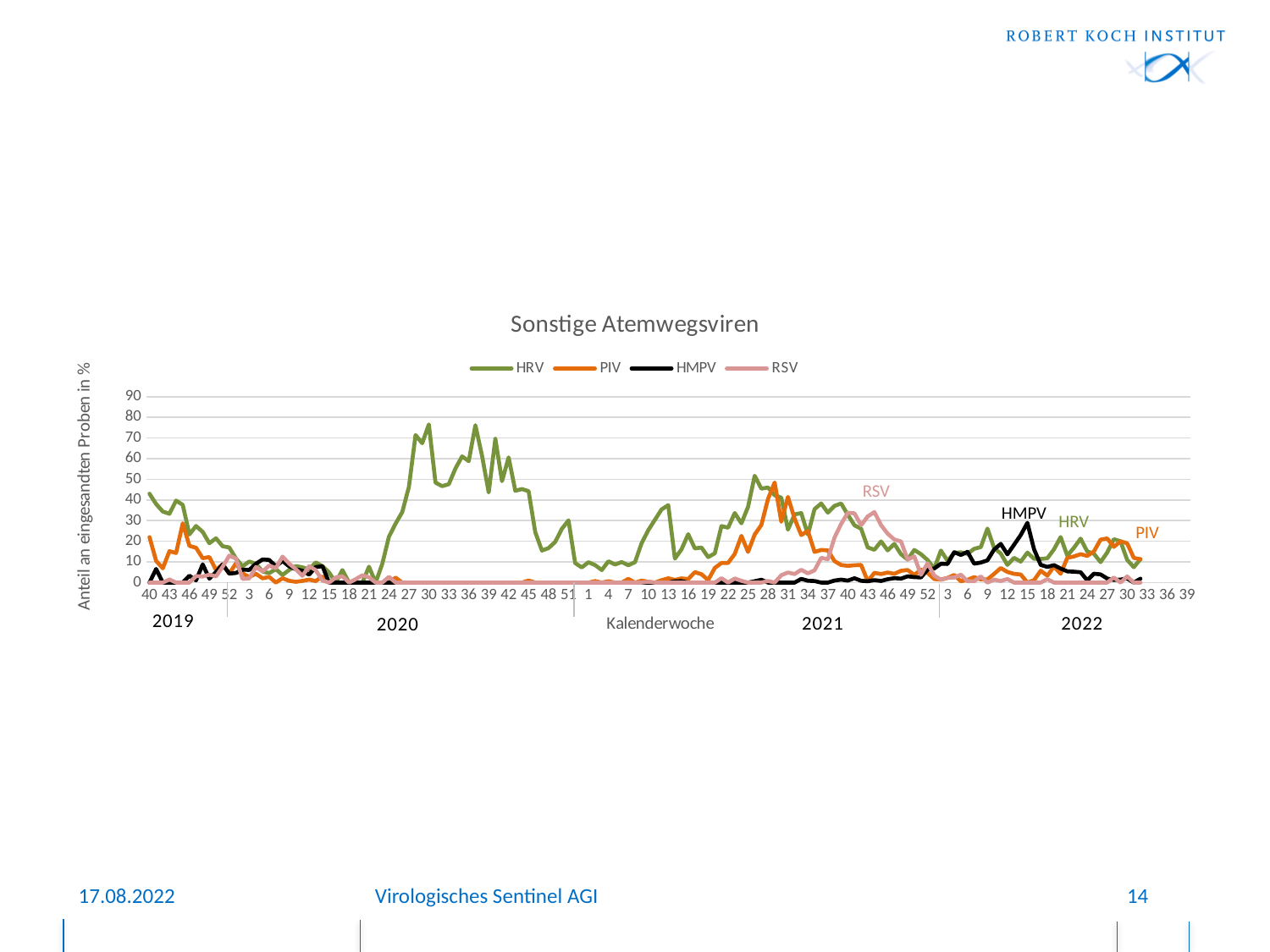
How many series does the legend list? 4 Is the peak value of HMPV in 2022 greater or less than 50? less What is the title of the chart? Sonstige Atemwegsviren Does the HRV line rise or fall between calendar week 30 and calendar week 48 of 2020? fall What is the highest tick value shown on the y axis? 90 Is the peak value of HRV in 2020 greater or less than 60? greater Which series reaches the highest value anywhere in the chart? HRV What kind of chart is shown on the slide? line chart Is the peak value of PIV in 2021 greater or less than 30? greater What is the label of the y axis? Anteil an eingesandten Proben in % Which is larger: the peak of HRV in 2020 or the peak of PIV in 2021? the peak of HRV in 2020